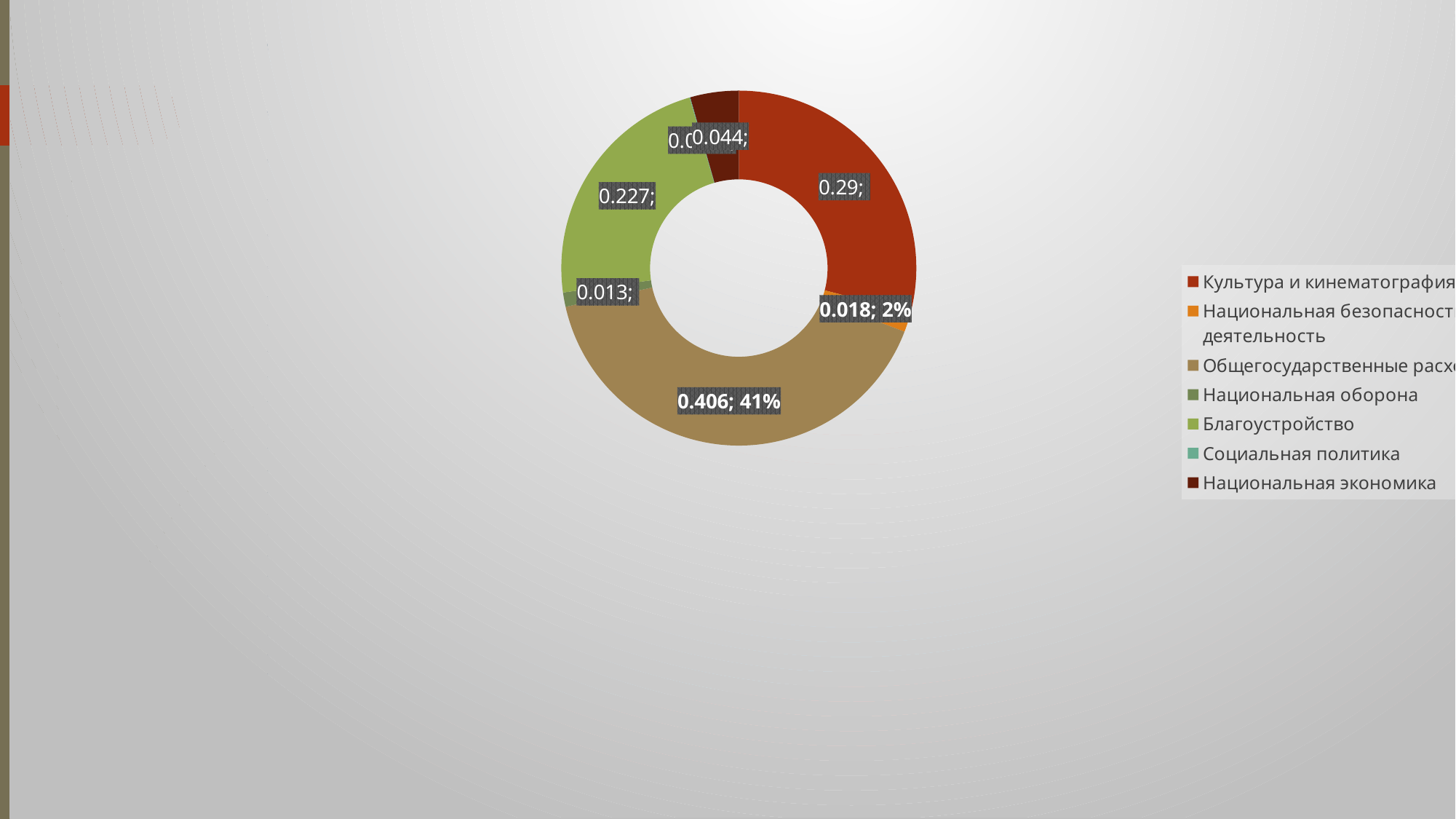
What colour is the slice for Благоустройство? light green Which is larger, the value for Культура и кинематография or for Благоустройство? Культура и кинематография How many categories does the legend list? 7 What is the largest value label shown on the chart? 0.406 What value is shown for Благоустройство? 0.227 What value is shown for Национальная оборона? 0.013 What value is shown for Культура и кинематография? 0.29 What value is shown for Национальная экономика? 0.044 What percentage share is printed on the largest slice of the chart? 41% Which is larger, the value for Национальная экономика or for Национальная оборона? Национальная экономика What kind of chart is shown on the slide? pie (doughnut) chart What is the difference between the values for Культура и кинематография and Благоустройство? 0.063